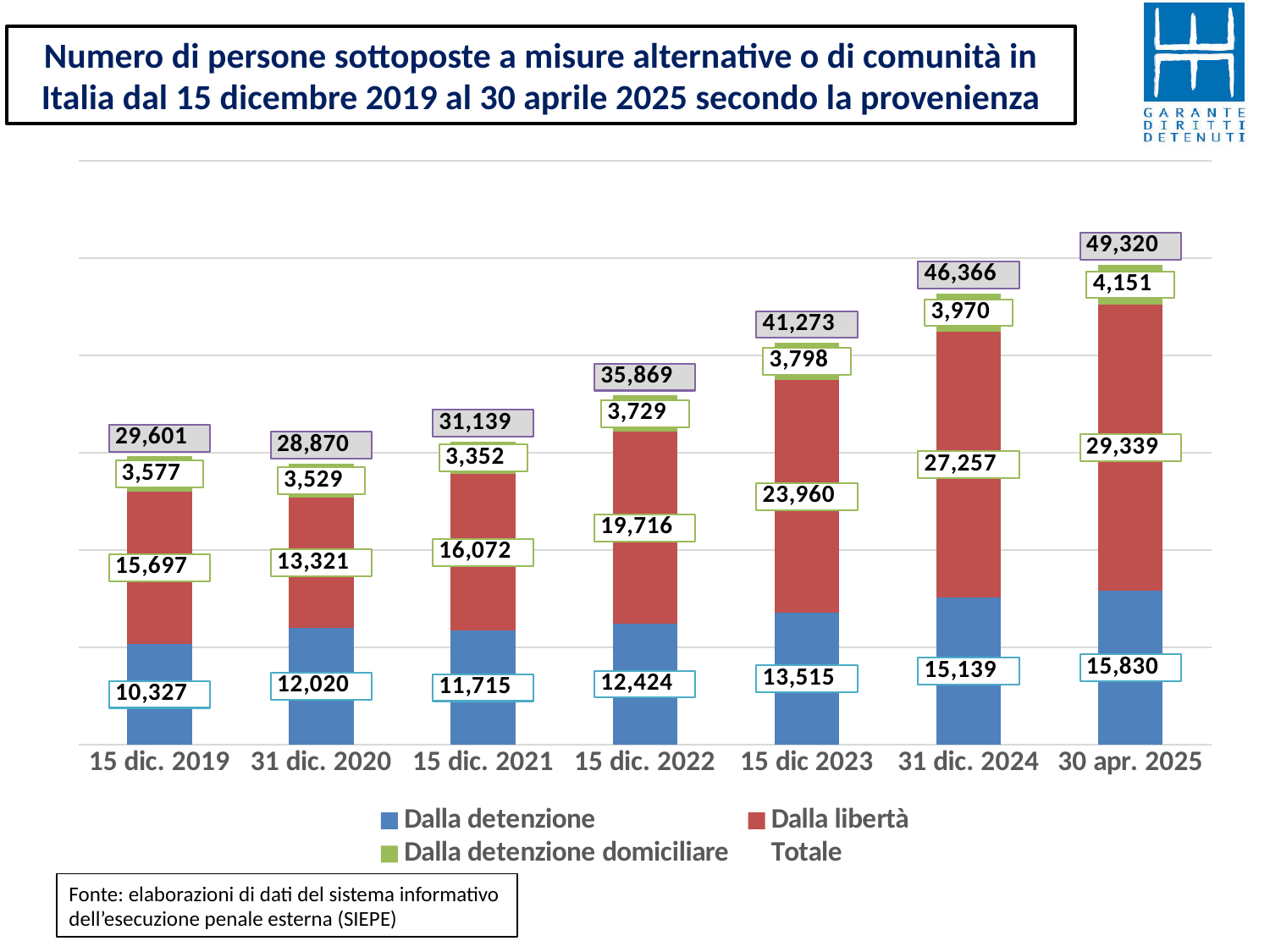
How many dates are shown on the x axis? 7 What is the total (Totale) shown for 15 dic. 2022? 35,869 Which date has the highest total? 30 apr. 2025 How many entries does the legend list? 4 What is the value for "Dalla detenzione domiciliare" on 30 apr. 2025? 4,151 Which is larger: "Dalla libertà" on 31 dic. 2024 or "Dalla libertà" on 15 dic 2023? 31 dic. 2024 What type of chart is shown on the slide? Stacked bar chart Does the total rise or fall from 15 dic. 2021 to 30 apr. 2025? Rise Which date has the lowest total? 31 dic. 2020 What is the difference between the total on 30 apr. 2025 and the total on 15 dic. 2019? 19,719 What is the value for "Dalla libertà" on 15 dic 2023? 23,960 What is the value for "Dalla detenzione" on 15 dic. 2019? 10,327